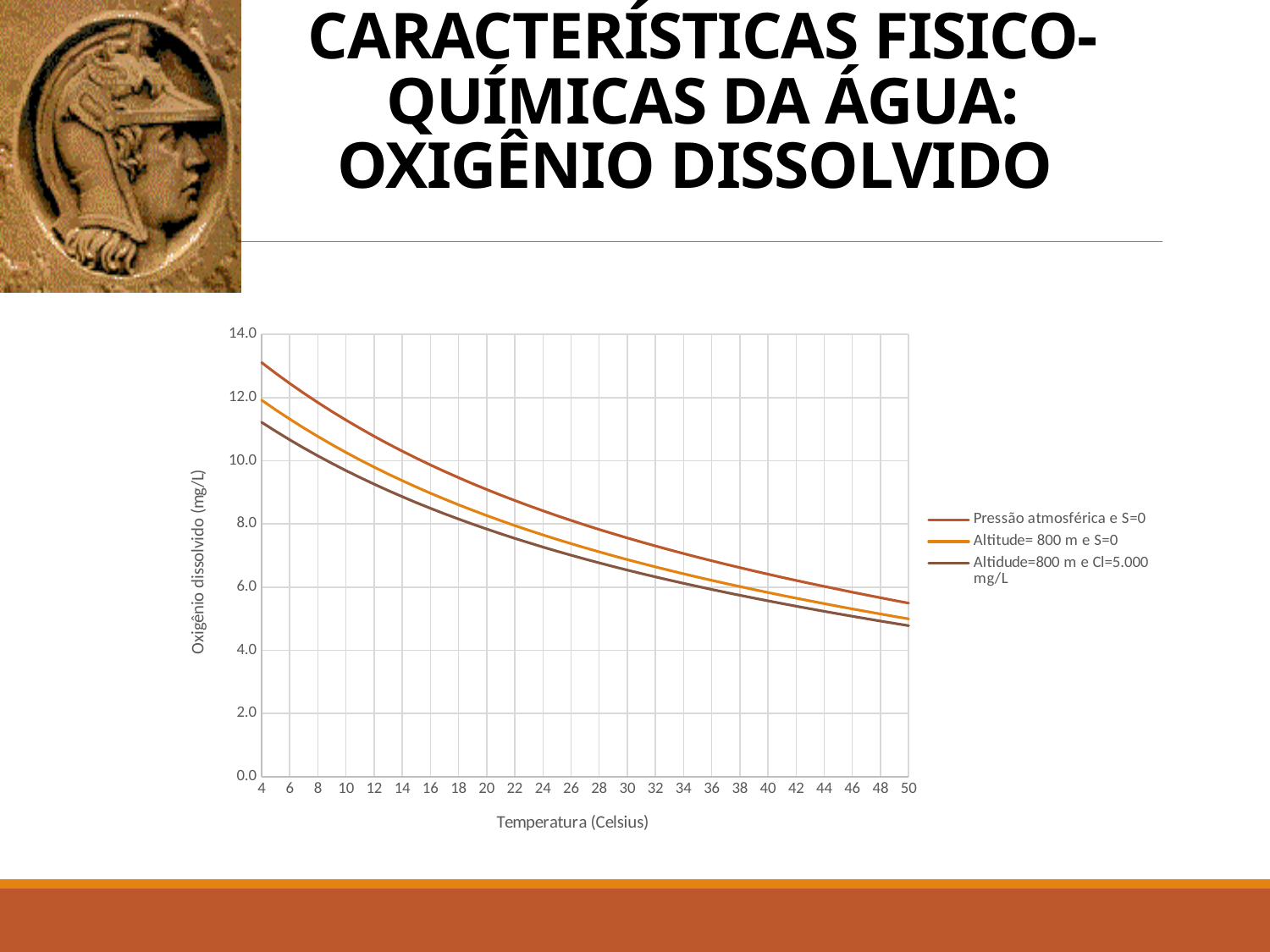
Is the value for "Pressão atmosférica e S=0" at 50 °C greater or less than 6.0? less Is the value for "Altitude= 800 m e S=0" at 50 °C greater or less than 6.0? less Is the value for "Pressão atmosférica e S=0" at 4 °C greater or less than 12.0? greater What is the title of the y axis? Oxigênio dissolvido (mg/L) Do the values of the series "Pressão atmosférica e S=0" rise or fall as temperature increases along the x axis? fall What is the title of the x axis? Temperatura (Celsius) Which series has the lowest dissolved oxygen values across the temperature range? Altidude=800 m e Cl=5.000 mg/L Which series has the highest dissolved oxygen values across the temperature range? Pressão atmosférica e S=0 At 30 °C, which series has the larger value: "Pressão atmosférica e S=0" or "Altidude=800 m e Cl=5.000 mg/L"? Pressão atmosférica e S=0 How many series does the legend list? 3 What kind of chart is shown on the slide? line chart